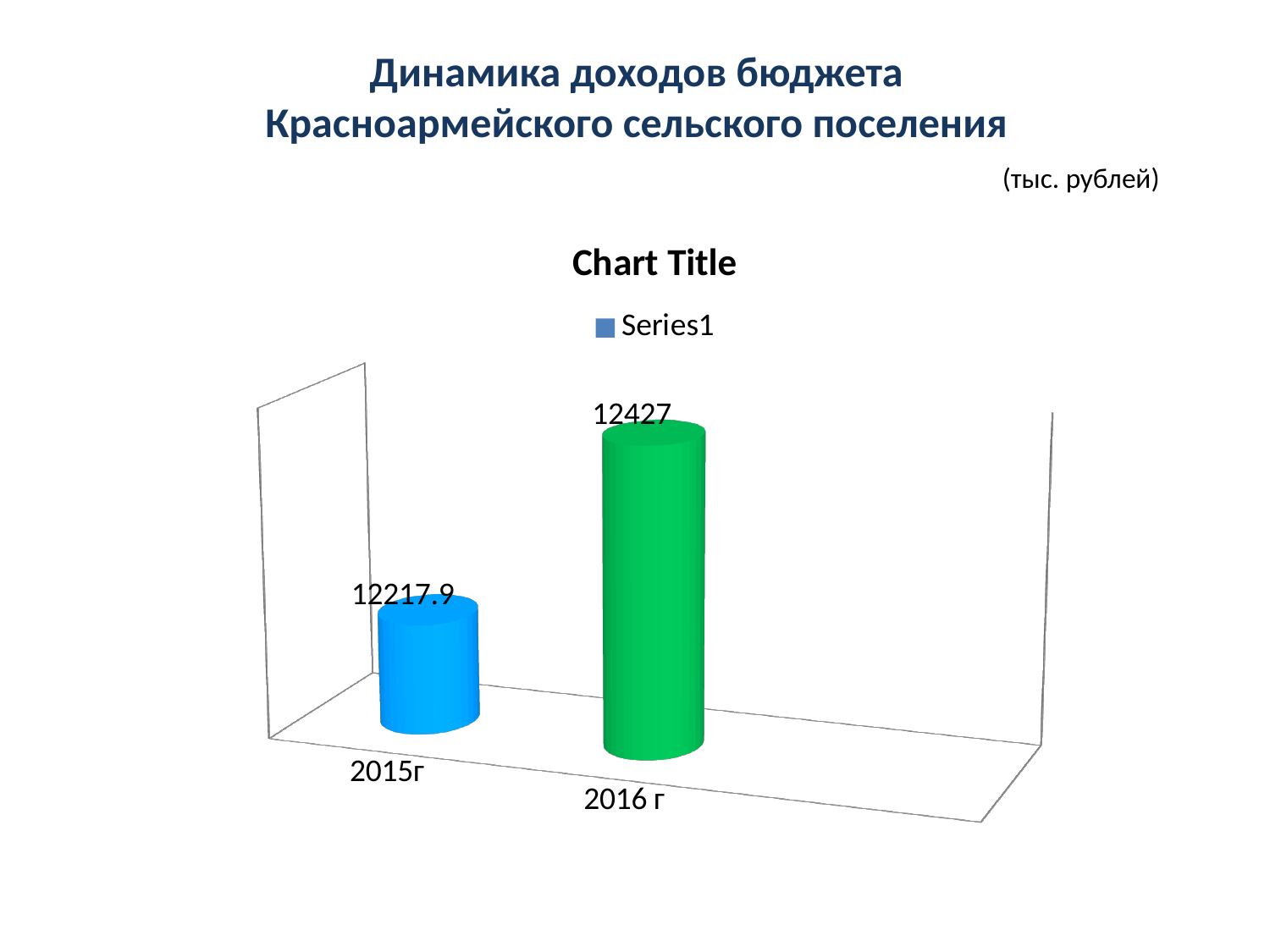
How many series does the legend list? 1 Which is larger, the value for 2015г or the value for 2016 г? 2016 г What is the value for 2015г? 12217.9 What unit is stated for the values on the slide? тыс. рублей Which year has the highest value? 2016 г What is the value for 2016 г? 12427 What is the name of the series listed in the legend? Series1 How many categories are shown on the chart? 2 Do the values rise or fall from 2015г to 2016 г? Rise What kind of chart is shown on the slide? Bar chart Which year has the lowest value? 2015г What is the difference between the values for 2016 г and 2015г? 209.1